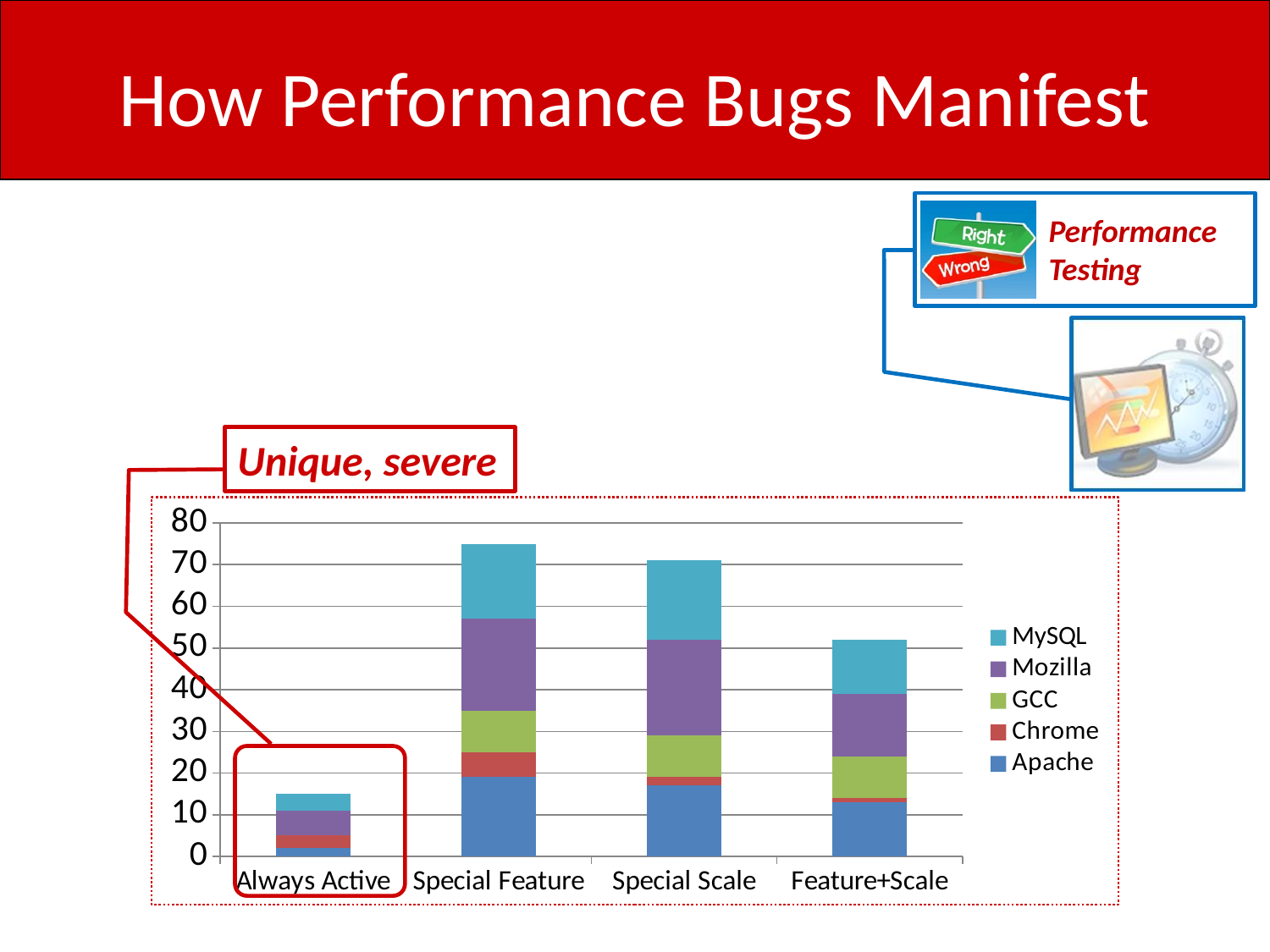
How many series does the chart's legend list? 5 Is the total for Special Scale greater or less than 60? greater Is the total for Special Feature greater or less than 70? greater Is the total for Always Active greater or less than 20? less Which category has the lowest total stacked bar? Always Active Which has the larger total stacked bar, Always Active or Feature+Scale? Feature+Scale How many categories are shown on the x axis of the chart? 4 Which category has the highest total stacked bar? Special Feature Which series is shown at the bottom of each stacked bar? Apache What are the series names listed in the chart's legend? MySQL, Mozilla, GCC, Chrome, Apache What kind of chart is shown on the slide? Stacked bar chart